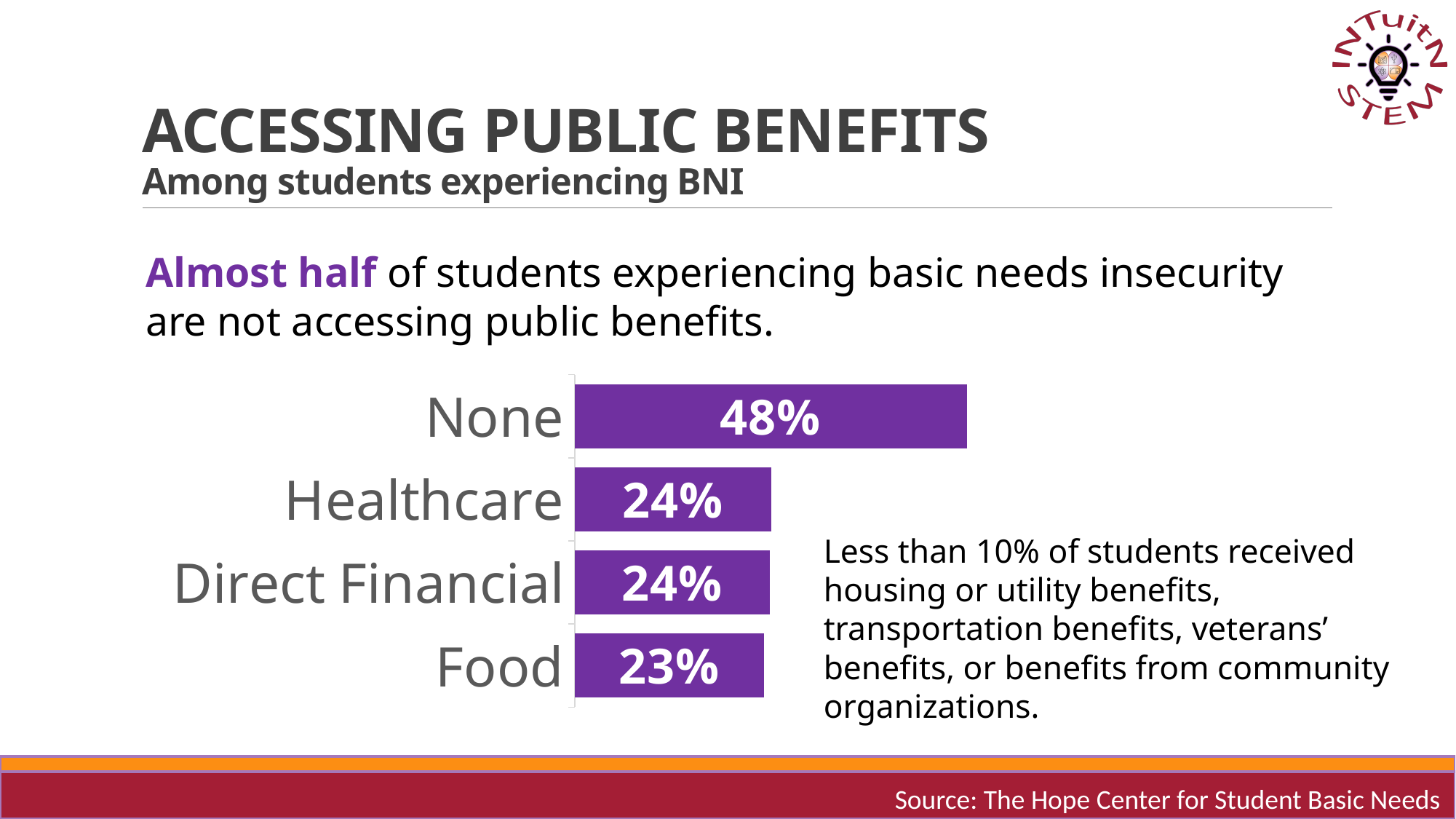
What is the value shown for Direct Financial? 24% What is the value shown for Food? 23% Which category has the lowest value in the chart? Food How many categories are shown in the chart? 4 What kind of chart is shown on the slide? Bar chart Which is larger, the value for None or the value for Food? None What percentage of students experiencing BNI accessed no public benefits (None)? 48% What colour are the bars in the chart? Purple Which category has the highest value in the chart? None What is the value shown for Healthcare? 24% What is the difference between the value for None and the value for Healthcare? 24% What is the difference between the value for Direct Financial and the value for Food? 1%